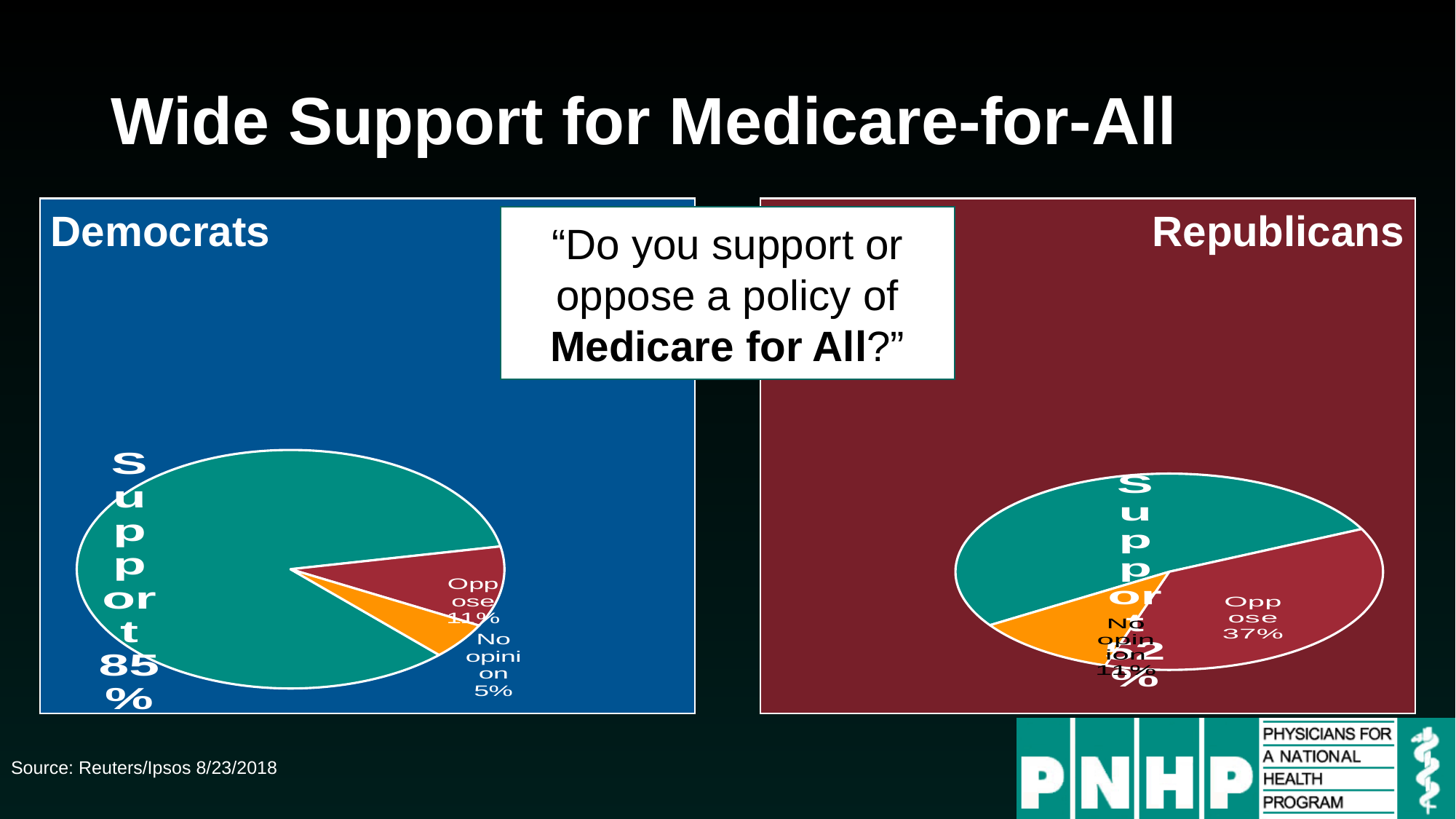
In the Democrats pie chart, how many percentage points higher is Support than Oppose? 74 How many slices does the Democrats pie chart have? 3 In the Democrats pie chart, what percentage oppose Medicare for All? 11% In the Democrats pie chart, what percentage have no opinion? 5% In the Republicans pie chart, what percentage oppose Medicare for All? 37% In the Democrats pie chart, which response is the largest slice? Support What source is cited for the data on the slide? Reuters/Ipsos 8/23/2018 What kind of chart is used on the Democrats panel? Pie chart In the Democrats pie chart, what percentage support Medicare for All? 85% In the Democrats pie chart, which response is the smallest slice? No opinion In the Republicans pie chart, which response is the largest slice? Support Which group has a larger Oppose share, Democrats or Republicans? Republicans